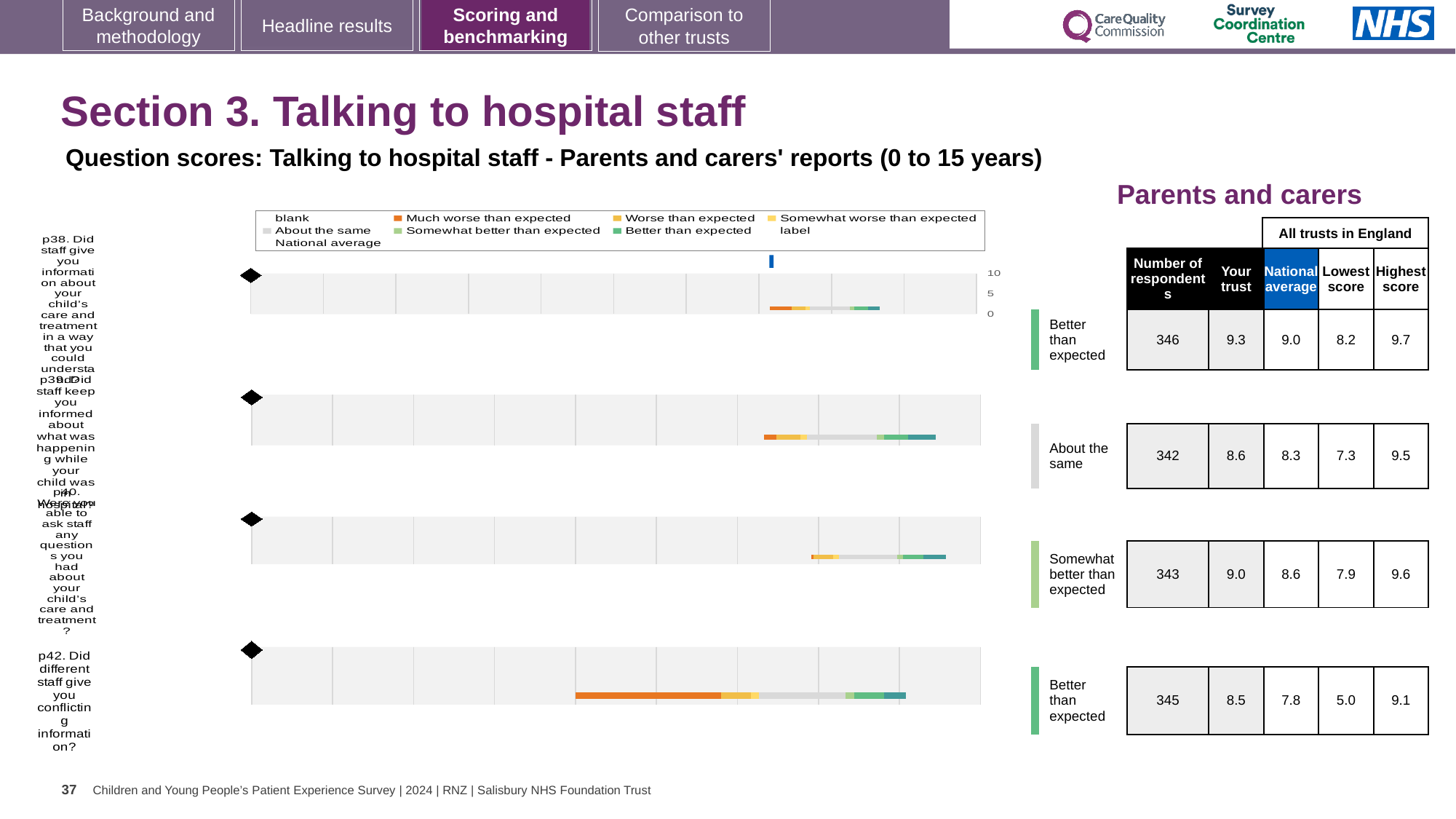
In the table next to the charts, what is the lowest score across all trusts in England for p42 (conflicting information)? 5.0 In the chart legend, what colour represents 'Much worse than expected'? orange In the table next to the charts, which question has the lowest national average? p42 In the table next to the charts, how many respondents answered p40 (able to ask staff questions)? 343 In the table next to the charts, what is the national average for p39 (staff keeping you informed)? 8.3 In the table next to the charts, which question has the highest 'Your trust' score? p38 In the table next to the charts, what is the difference between the 'Your trust' score and the national average for p42? 0.7 In the table next to the charts, is the 'Your trust' score for p40 higher or lower than the national average for p40? higher What is the maximum value shown on the horizontal axis of the top chart (p38)? 10 In the table next to the charts, what is the 'Your trust' score for p38 (information about your child's care and treatment)? 9.3 What kind of chart is used for the question scores on this slide? bar chart How many separate question charts (p38, p39, p40, p42) are shown on the slide? 4